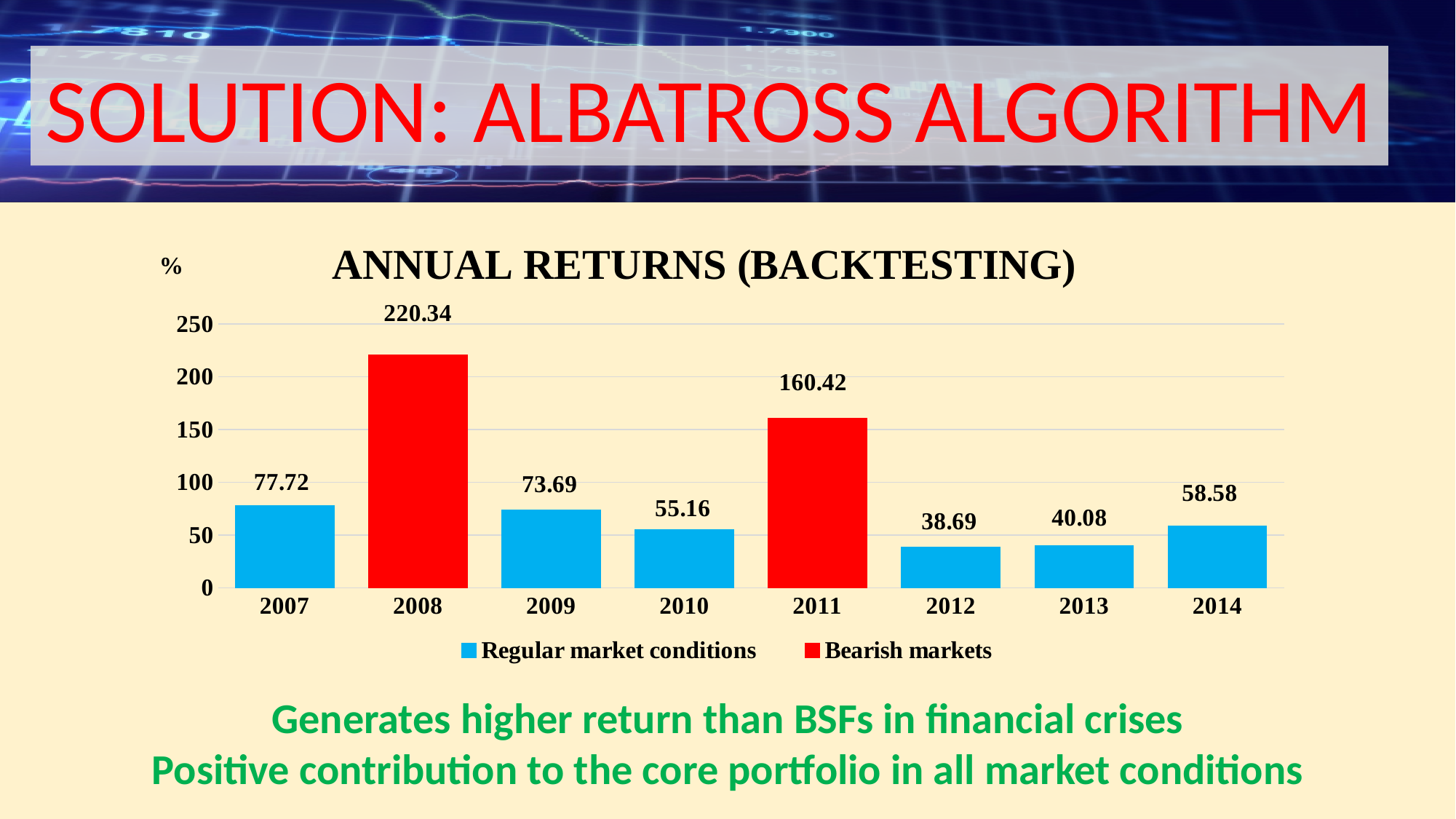
Which legend entry is shown in red? Bearish markets Which year has the lowest annual return? 2012 What kind of chart is shown on the slide? Bar chart What is the annual return shown for 2008? 220.34 Is the value for 2014 greater or less than 50? greater How many years are shown on the x axis? 8 What is the difference between the annual returns for 2008 and 2011? 59.92 How many series does the legend list? 2 Which year has the larger annual return, 2007 or 2009? 2007 What is the annual return shown for 2011? 160.42 Which year has the highest annual return? 2008 What is the annual return shown for 2012? 38.69